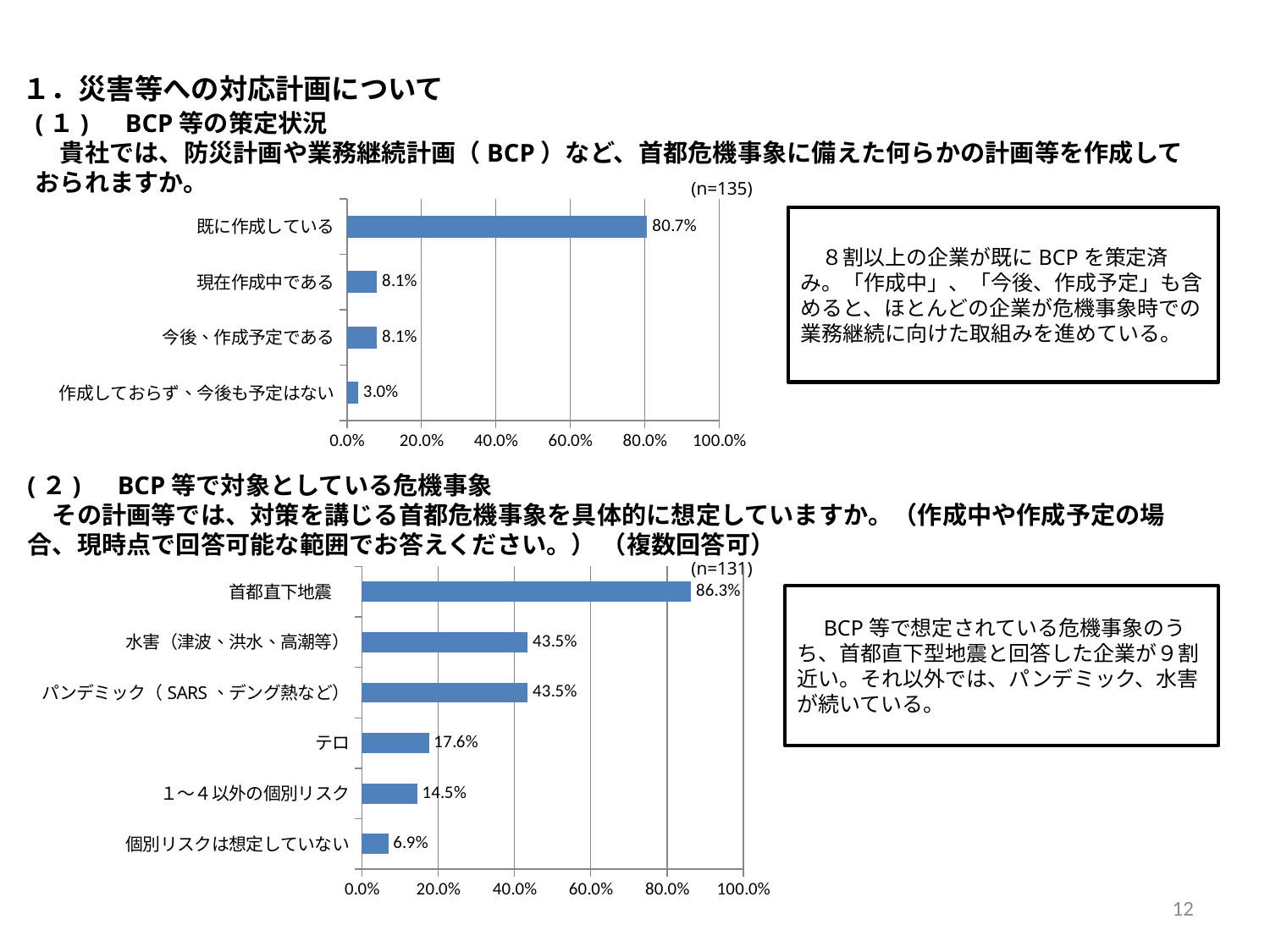
In the top chart (BCP等の策定状況), what is the difference between 既に作成している and 現在作成中である? 72.6% In the bottom chart (BCP等で対象としている危機事象), how many categories are shown? 6 In the bottom chart (BCP等で対象としている危機事象), which category has the lowest value? 個別リスクは想定していない In the bottom chart (BCP等で対象としている危機事象), what is the difference between 首都直下地震 and 水害（津波、洪水、高潮等）? 42.8% In the top chart (BCP等の策定状況), what is the value for 既に作成している? 80.7% In the top chart (BCP等の策定状況), what is the value for 作成しておらず、今後も予定はない? 3.0% In the bottom chart (BCP等で対象としている危機事象), what is the value for 首都直下地震? 86.3% What type of chart is the bottom chart (BCP等で対象としている危機事象)? Bar chart In the bottom chart (BCP等で対象としている危機事象), what is the value for テロ? 17.6% In the bottom chart (BCP等で対象としている危機事象), which is larger: テロ or 1～4以外の個別リスク? テロ In the top chart (BCP等の策定状況), which category has the highest value? 既に作成している In the top chart (BCP等の策定状況), how many categories are shown? 4